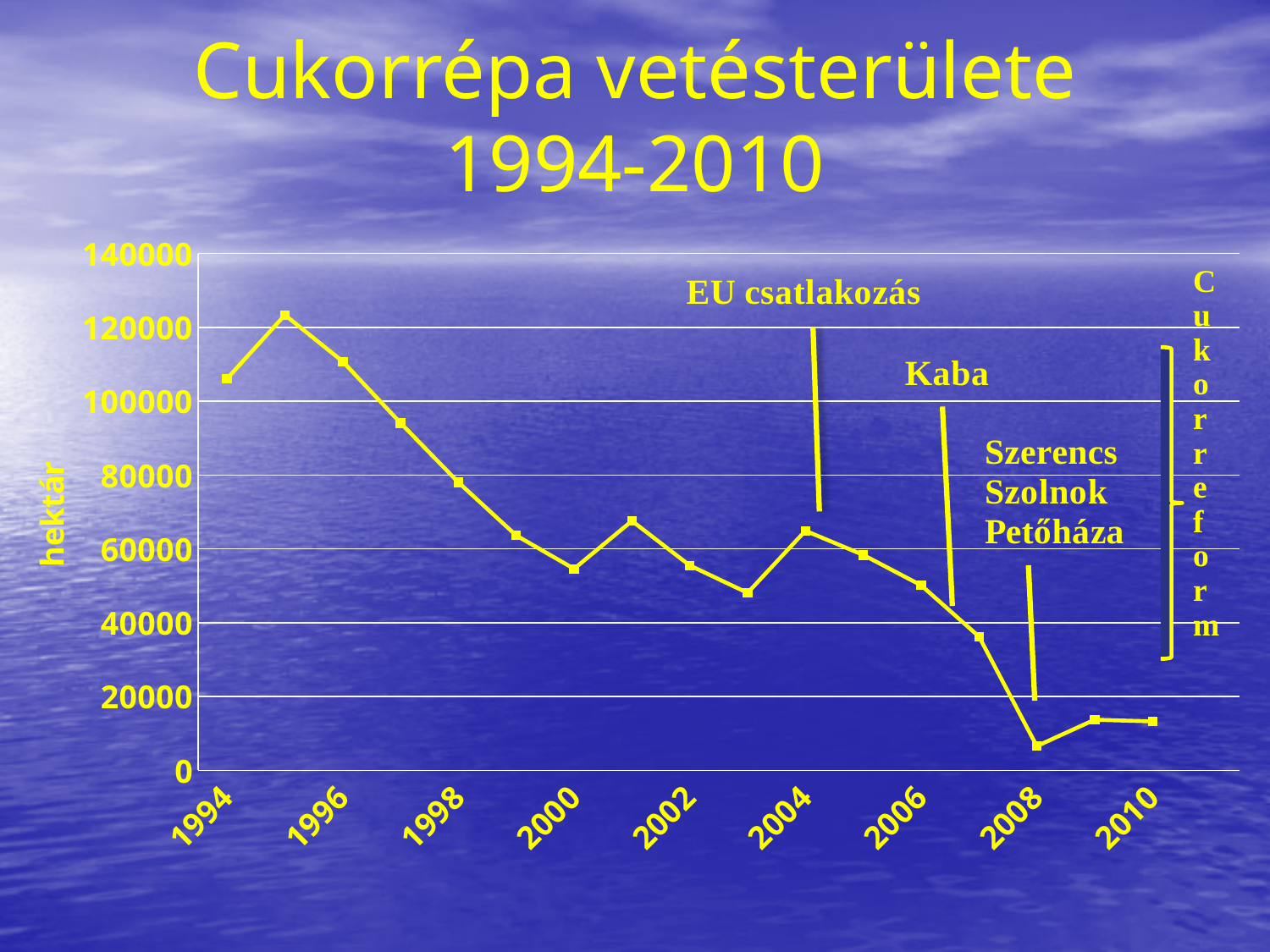
Is the value for 2000 greater or less than 60000? less Is the value for 2006 greater or less than 40000? greater Overall, do the values rise or fall from 1994 to 2010? fall Is the value for 2008 greater or less than 20000? less What unit is shown on the vertical axis label? hektár How many years are labeled on the x axis? 9 What is the title of the chart on the slide? Cukorrépa vetésterülete 1994-2010 What kind of chart is shown on the slide? line chart Which is larger, the value for 1994 or the value for 2010? 1994 Which labeled year on the x axis has the lowest value? 2008